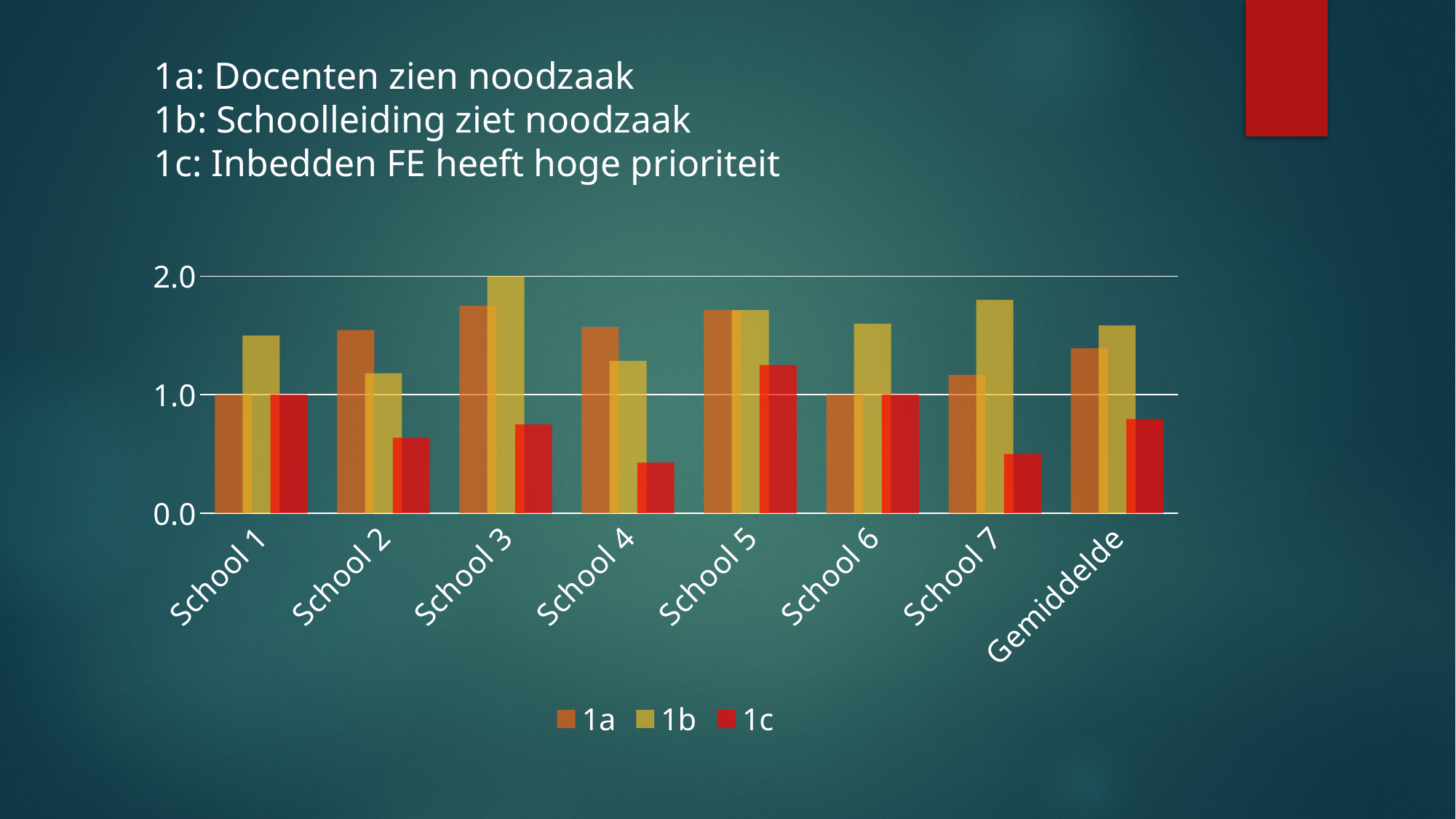
What is the value of series 1b for School 3? 2.0 What is the value of series 1c for School 6? 1.0 Is the value of series 1a for School 3 greater or less than 1.0? greater What are the three series names listed in the legend? 1a, 1b, 1c What kind of chart is shown on the slide? bar chart Which category has the highest value for series 1c? School 5 What is the value of series 1a for School 1? 1.0 How many categories are shown on the x axis? 8 Which school has the highest value for series 1b? School 3 Is the value of series 1c for School 4 greater or less than 1.0? less For School 3, which is larger: series 1b or series 1c? 1b How many series does the legend list? 3